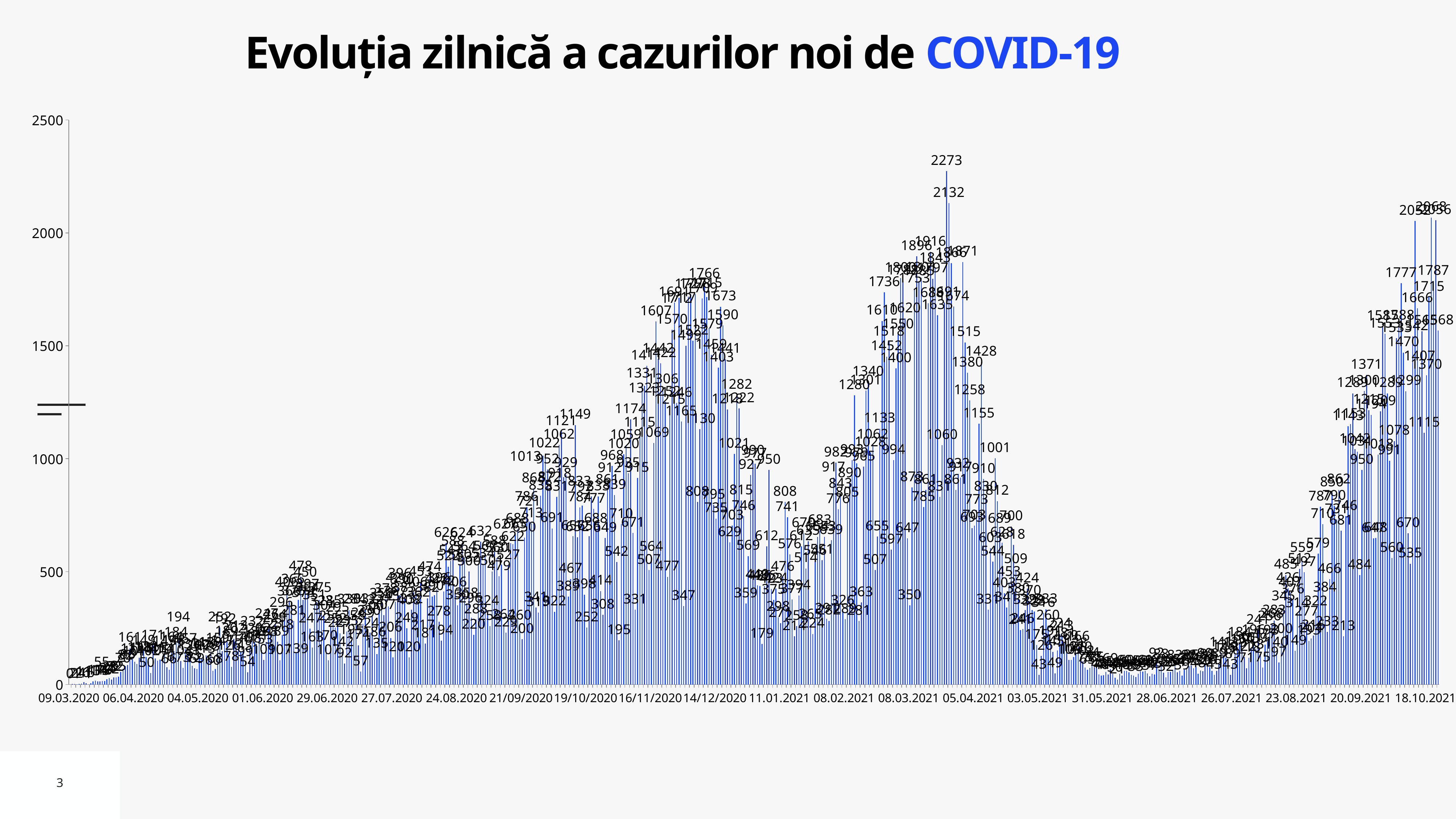
Is the December 2020 peak value of 1766 greater or less than 2000? less What is the last date label on the horizontal axis? 18.10.2021 What is the second highest value labelled on the chart, just below the 2273 peak? 2132 What is the difference between the two highest labelled values, 2273 and 2132? 141 What is the title of the chart? Evoluția zilnică a cazurilor noi de COVID-19 What is the maximum value shown on the vertical axis? 2500 What kind of chart is shown on the slide? bar chart What is the highest daily value labelled on the chart? 2273 What is the first date label on the horizontal axis? 09.03.2020 Is the highest value on the chart greater or less than 2000? greater Between 05.04.2021 and 31.05.2021, do the daily values rise or fall? fall Which is larger: the peak value of 2273 or the December 2020 peak of 1766? 2273